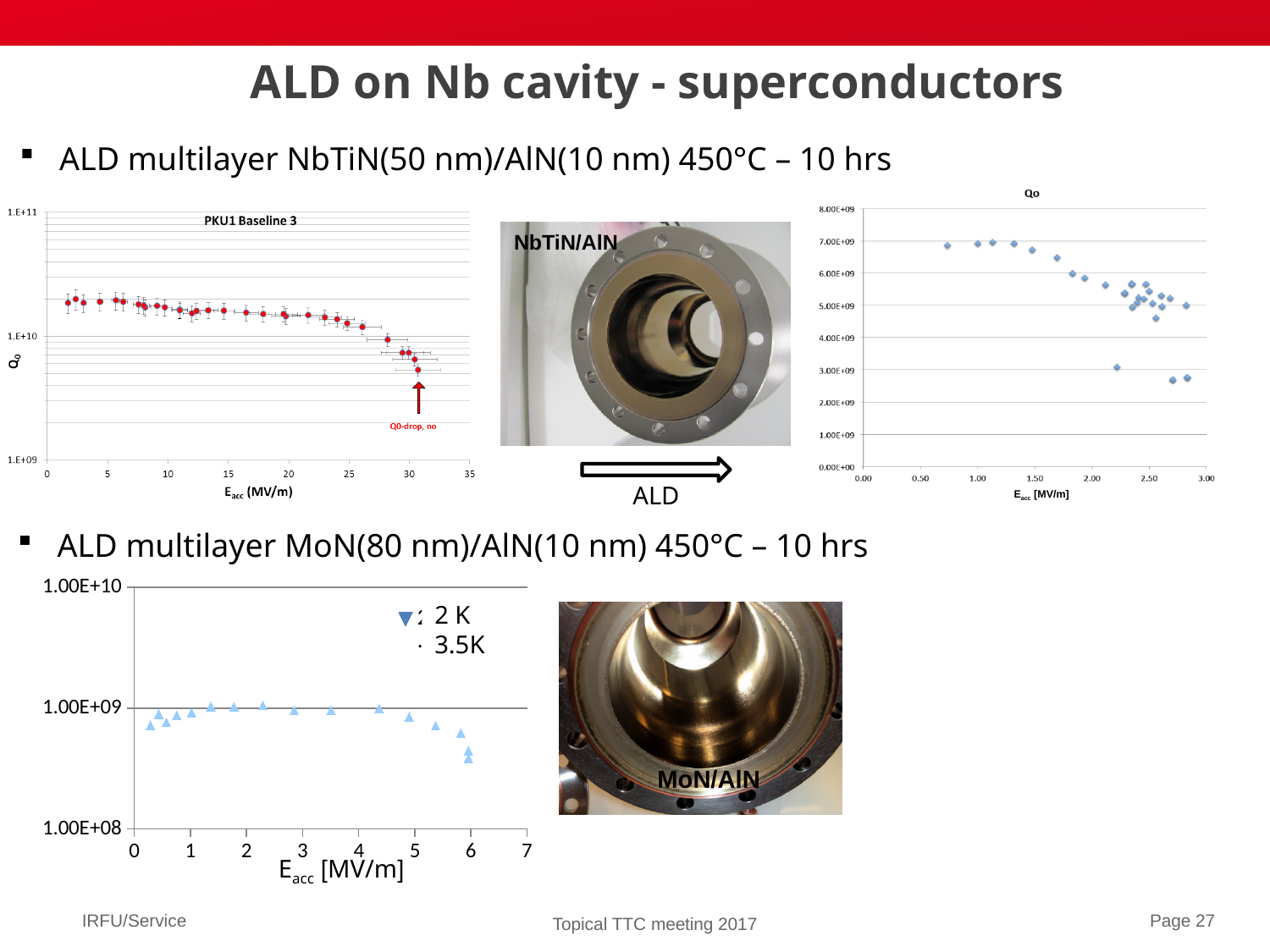
In the bottom-left chart (MoN/AlN), is the value at about 1 MV/m greater or less than 1.00E+09? less In the 'PKU1 Baseline 3' chart, do the Q0 values rise or fall as E_acc increases? fall In the 'PKU1 Baseline 3' chart, is the Q0 value at about 5 MV/m greater or less than 1.E+10? greater In the 'Qo' chart at the top right, is the value at about 1.00 MV/m greater or less than 6.00E+09? greater What is the title of the chart at the top right of the slide? Qo What kind of chart is the 'PKU1 Baseline 3' chart at the top left of the slide? scatter chart In the bottom-left chart (MoN/AlN), do the values rise or fall as E_acc goes from 4 to 6 MV/m? fall In the 'Qo' chart at the top right, do the values rise or fall as E_acc increases? fall